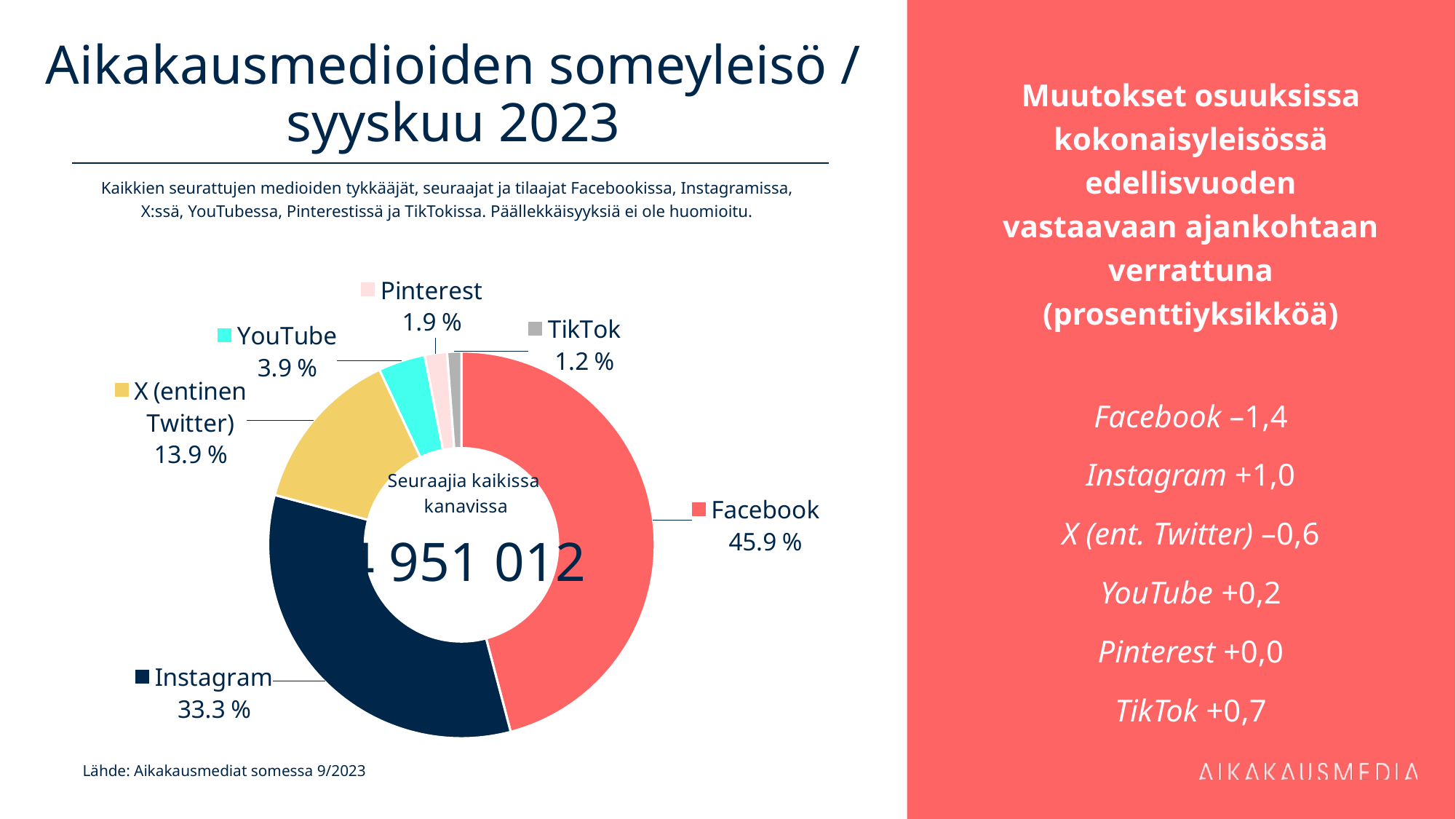
What share does YouTube have? 3.9 % What is the share for TikTok? 1.2 % What share does Instagram have in the chart? 33.3 % How many percentage points larger is Facebook's share than Instagram's? 12.6 What is the share for X (entinen Twitter)? 13.9 % What share of the social media audience does Facebook have? 45.9 % How many channels are shown in the chart? 6 What is the title of the slide containing the chart? Aikakausmedioiden someyleisö / syyskuu 2023 Which has a larger share, YouTube or Pinterest? YouTube Which channel has the smallest share in the chart? TikTok What kind of chart is shown on the slide? Pie chart (donut) Which channel has the largest share in the chart? Facebook